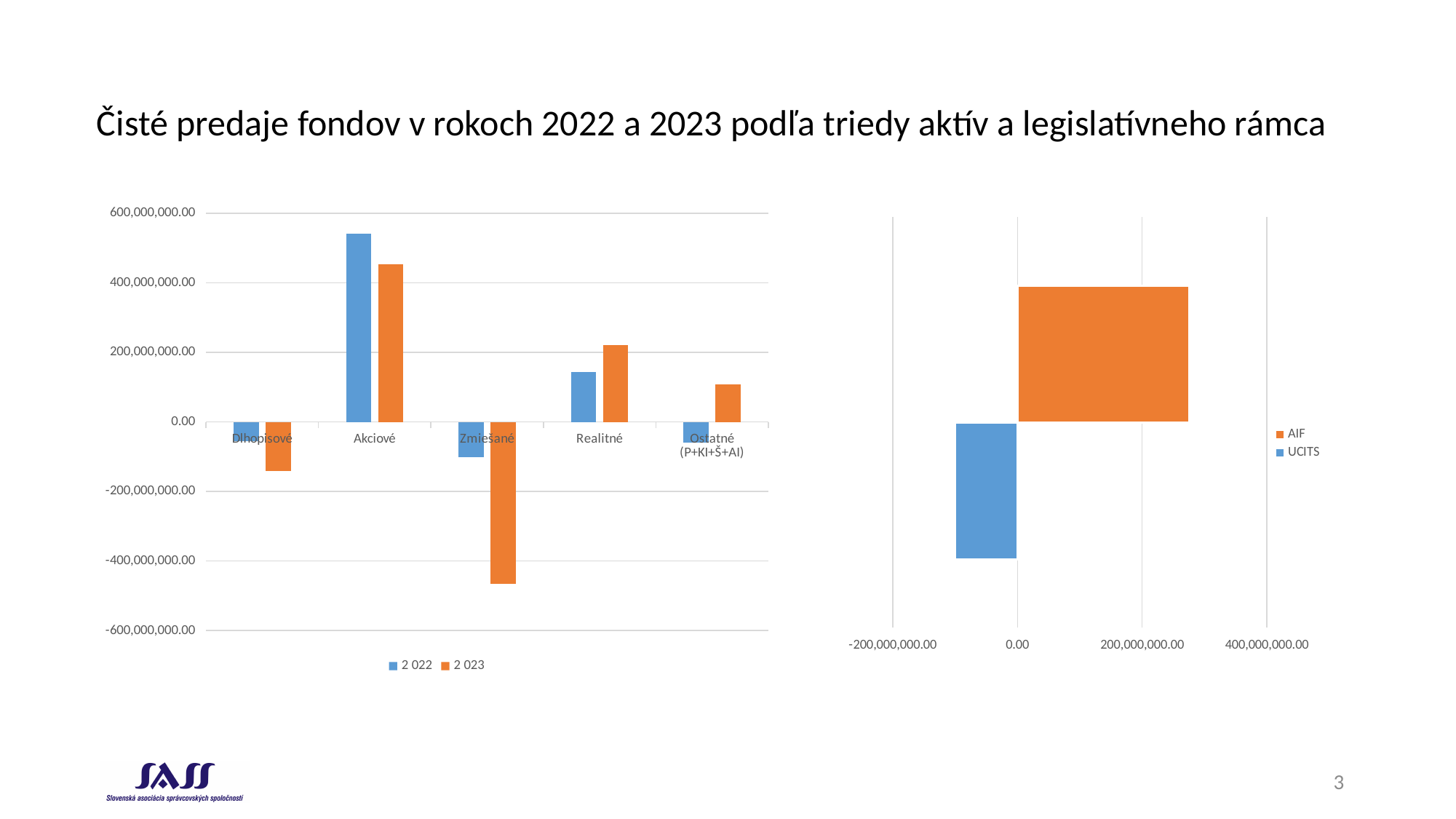
On the left chart, which category has the lowest value for the 2 023 series? Zmiešané On the right chart, which of the two series has the larger value, AIF or UCITS? AIF How many categories are shown on the left chart? 5 On the left chart, is the 2 023 value for Zmiešané greater or less than -400,000,000.00? less On the left chart, which is larger for Akciové: the 2 022 value or the 2 023 value? 2 022 On the right chart, is the value for AIF greater or less than 200,000,000.00? greater What kind of chart is the chart on the right? bar chart On the left chart, is the 2 023 value for Realitné greater or less than 200,000,000.00? greater How many series does the legend of the left chart list? 2 On the left chart, which is larger for Realitné: the 2 022 value or the 2 023 value? 2 023 On the left chart, which category has the highest value for the 2 022 series? Akciové